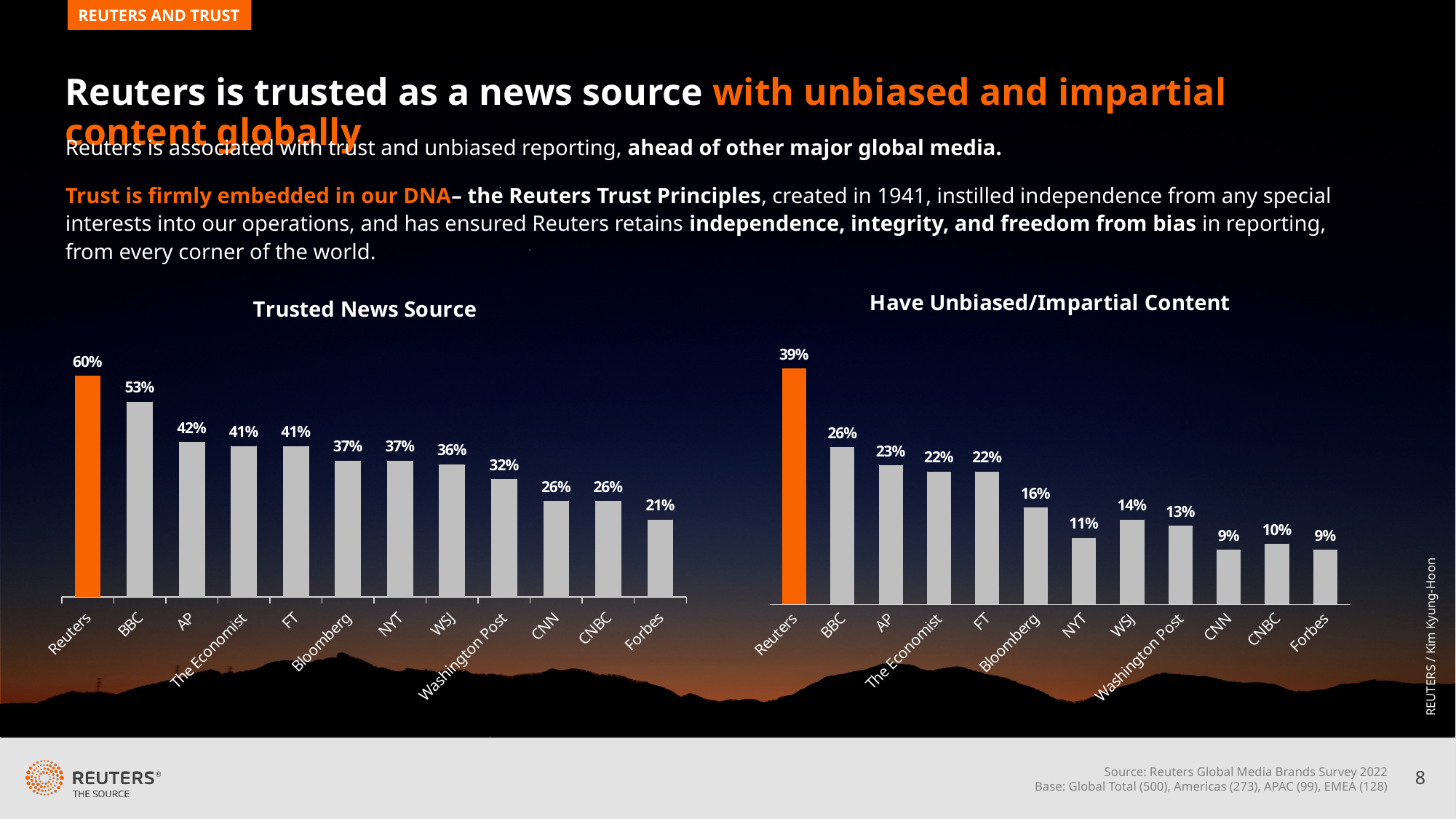
In the 'Trusted News Source' chart, what is the difference between Reuters and BBC? 7% In the 'Have Unbiased/Impartial Content' chart, what is the difference between Reuters and AP? 16% In the 'Trusted News Source' chart, what is the value for Reuters? 60% In the 'Have Unbiased/Impartial Content' chart, what is the value for BBC? 26% In the 'Have Unbiased/Impartial Content' chart, which is larger, the value for NYT or the value for WSJ? WSJ In the 'Trusted News Source' chart, which outlet has the lowest value? Forbes In the 'Trusted News Source' chart, which bar is coloured orange? Reuters What kind of chart is the 'Have Unbiased/Impartial Content' chart? Bar chart How many outlets are shown in the 'Trusted News Source' chart? 12 In the 'Trusted News Source' chart, do the values generally rise or fall from left to right? Fall In the 'Have Unbiased/Impartial Content' chart, which outlet has the highest value? Reuters In the 'Trusted News Source' chart, which is larger, the value for Washington Post or the value for CNN? Washington Post